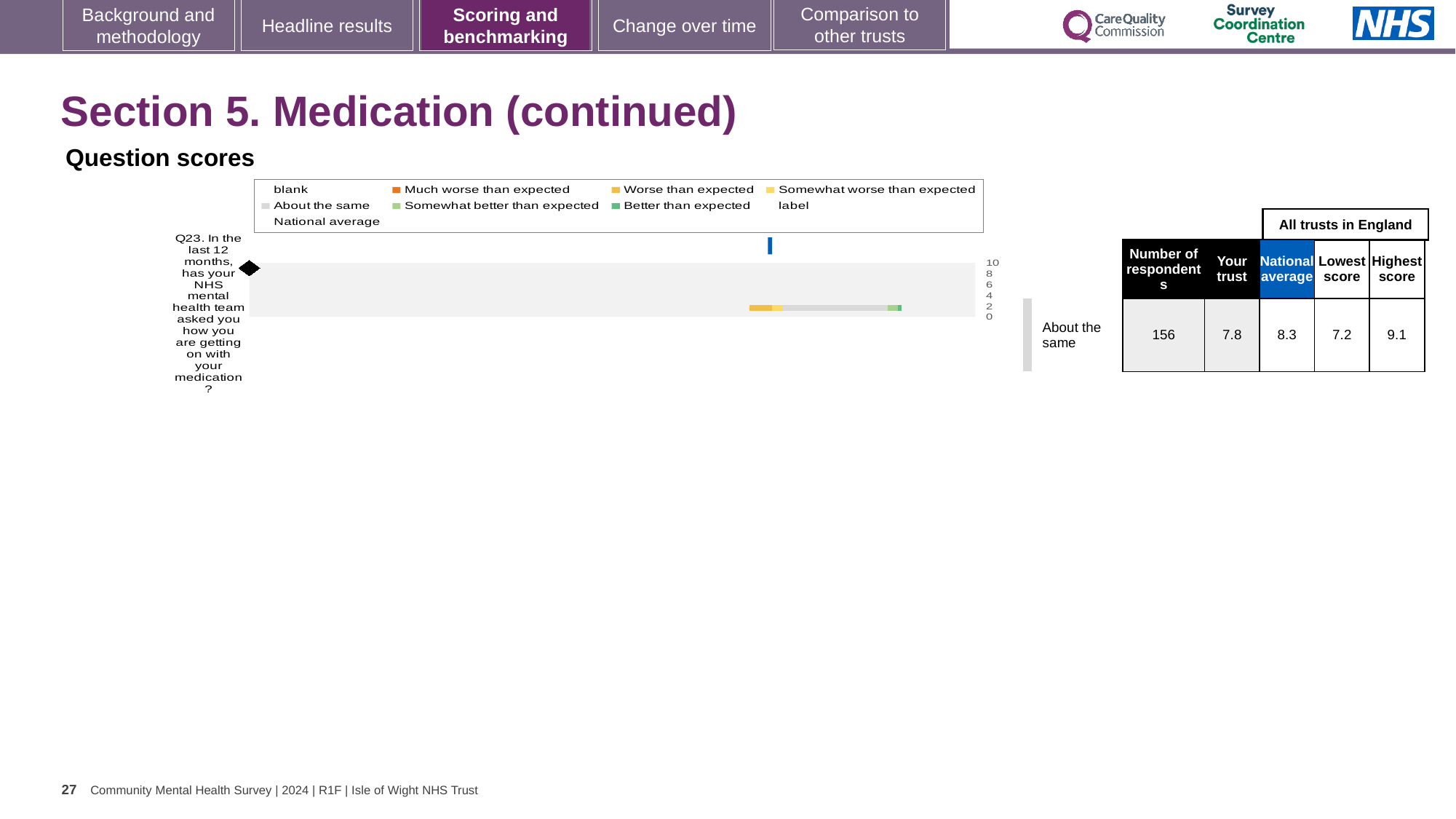
How many respondents answered Q23? 156 Which is larger for Q23, the 'Your trust' score or the national average? National average Which question is plotted in the Question scores chart? Q23. In the last 12 months, has your NHS mental health team asked you how you are getting on with your medication? What is the lowest score among all trusts in England for Q23? 7.2 What is the 'Your trust' score for Q23? 7.8 What is the national average score for Q23? 8.3 What is the highest score among all trusts in England for Q23? 9.1 What is the difference between the highest and lowest scores for Q23? 1.9 Is the national average marker for Q23 greater or less than 6 on the axis? greater How many survey questions are plotted in the Question scores chart? 1 What rating category is shown for Q23 next to the chart? About the same What type of chart is shown under 'Question scores'? bar chart